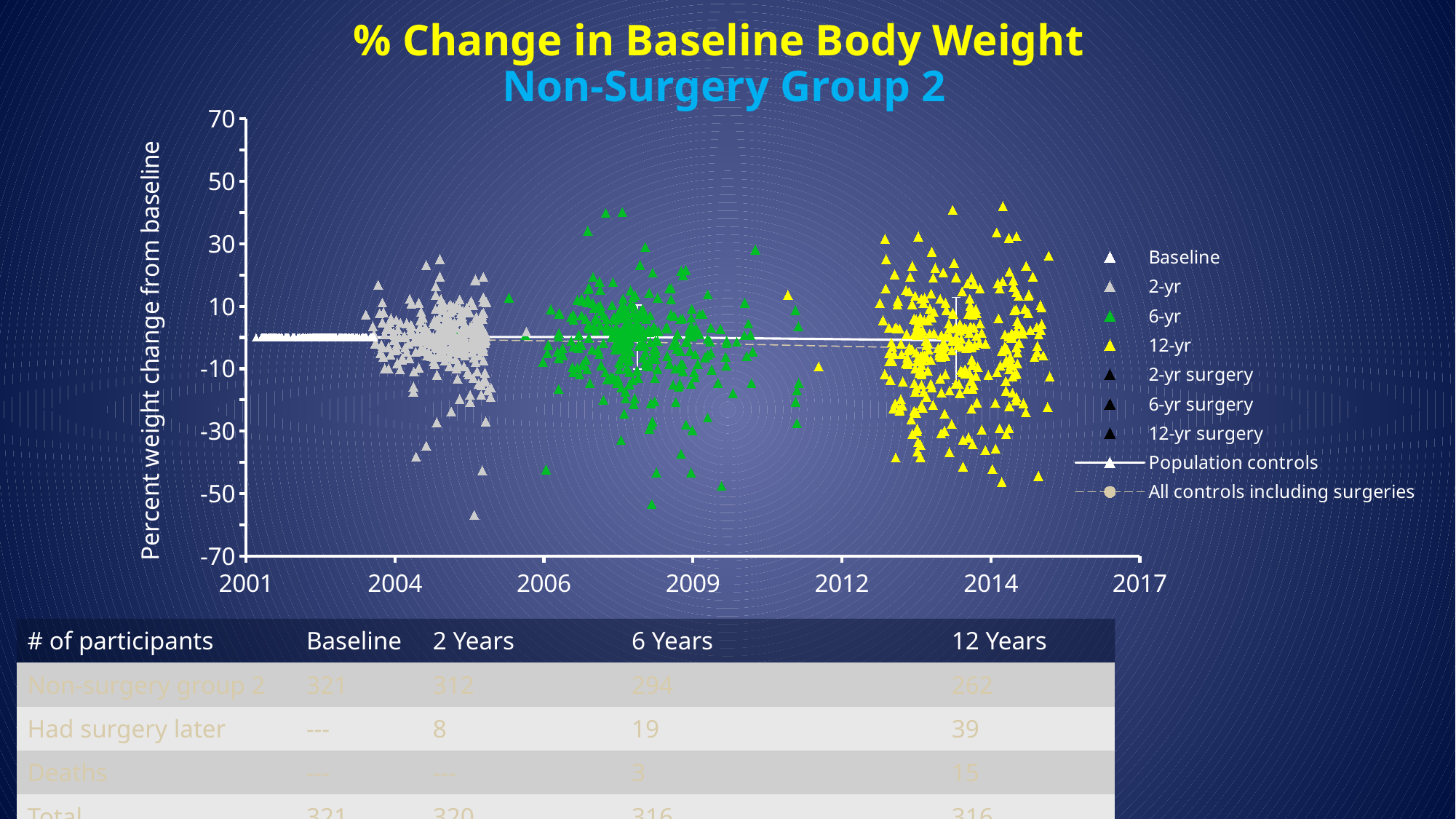
In the table below the chart, how many deaths are listed at 12 Years? 15 What is the highest value shown on the y axis of the chart? 70 What is the lowest value shown on the y axis of the chart? -70 In the table below the chart, how many participants were in Non-surgery group 2 at 12 Years? 262 What is the title of the chart? % Change in Baseline Body Weight, Non-Surgery Group 2 In the table below the chart, how many participants had surgery later by 6 Years? 19 What kind of chart is shown on the slide? Scatter chart How many series does the chart legend list? 9 What is the last year shown on the x axis of the chart? 2017 What is the first year shown on the x axis of the chart? 2001 In the table below the chart, how many participants were in Non-surgery group 2 at Baseline? 321 What is the label on the y axis of the chart? Percent weight change from baseline